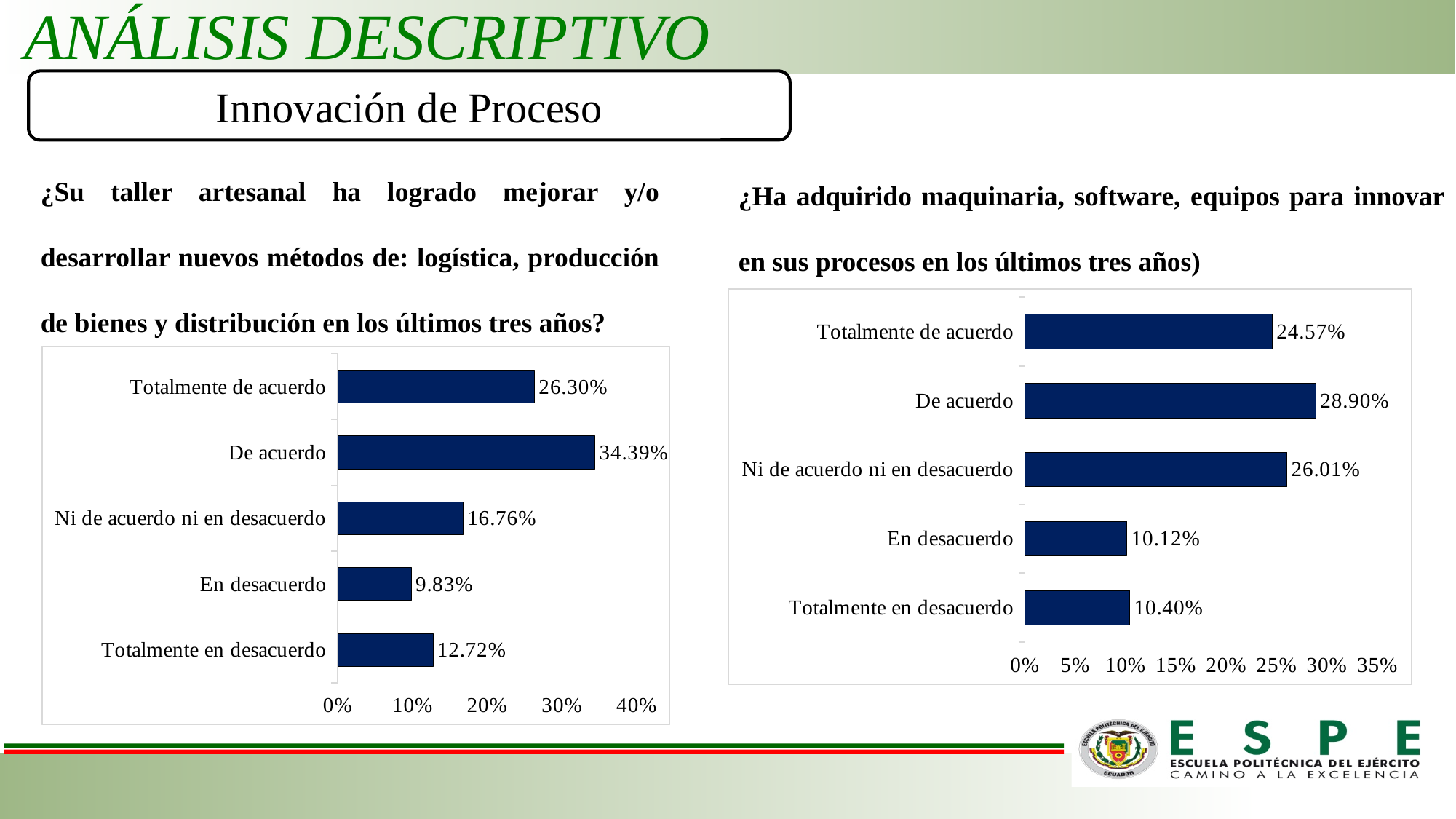
In the left chart, what is the value for 'De acuerdo'? 34.39% What kind of chart is the right chart? bar chart How many categories does the left chart show? 5 In the left chart, which category has the lowest value? En desacuerdo In the left chart, what is the difference between 'De acuerdo' and 'Totalmente de acuerdo'? 8.09% In the right chart, is the value for 'Totalmente de acuerdo' greater or less than 20%? greater In the right chart, what is the difference between 'De acuerdo' and 'En desacuerdo'? 18.78% In the left chart, which is larger: 'Totalmente en desacuerdo' or 'En desacuerdo'? Totalmente en desacuerdo What is the maximum value shown on the x axis of the left chart? 40% In the right chart, what is the value for 'Ni de acuerdo ni en desacuerdo'? 26.01% In the left chart, which category has the highest value? De acuerdo In the right chart, which category has the highest value? De acuerdo